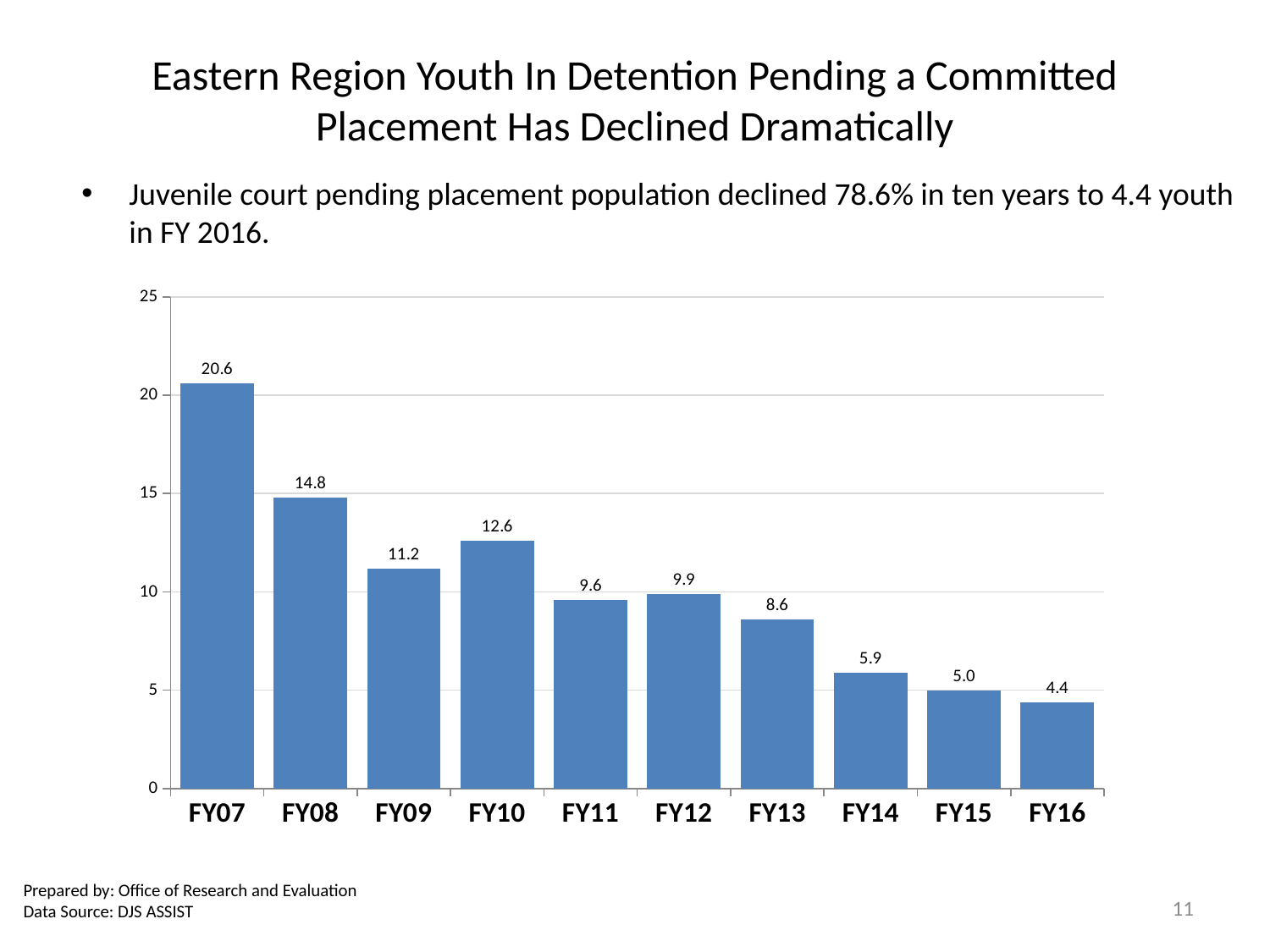
What is the difference between the values for FY07 and FY16? 16.2 What is the value for FY12? 9.9 Which fiscal year has the lowest value? FY16 Is the value for FY10 greater or less than 10? greater What is the difference between the values for FY08 and FY09? 3.6 How many fiscal years are shown on the x axis? 10 What is the value for FY16? 4.4 Which fiscal year has the highest value? FY07 What kind of chart is shown on the slide? Bar chart Do the values generally rise or fall from FY07 to FY16? Fall Which is larger, the value for FY11 or the value for FY12? FY12 What is the value for FY07? 20.6